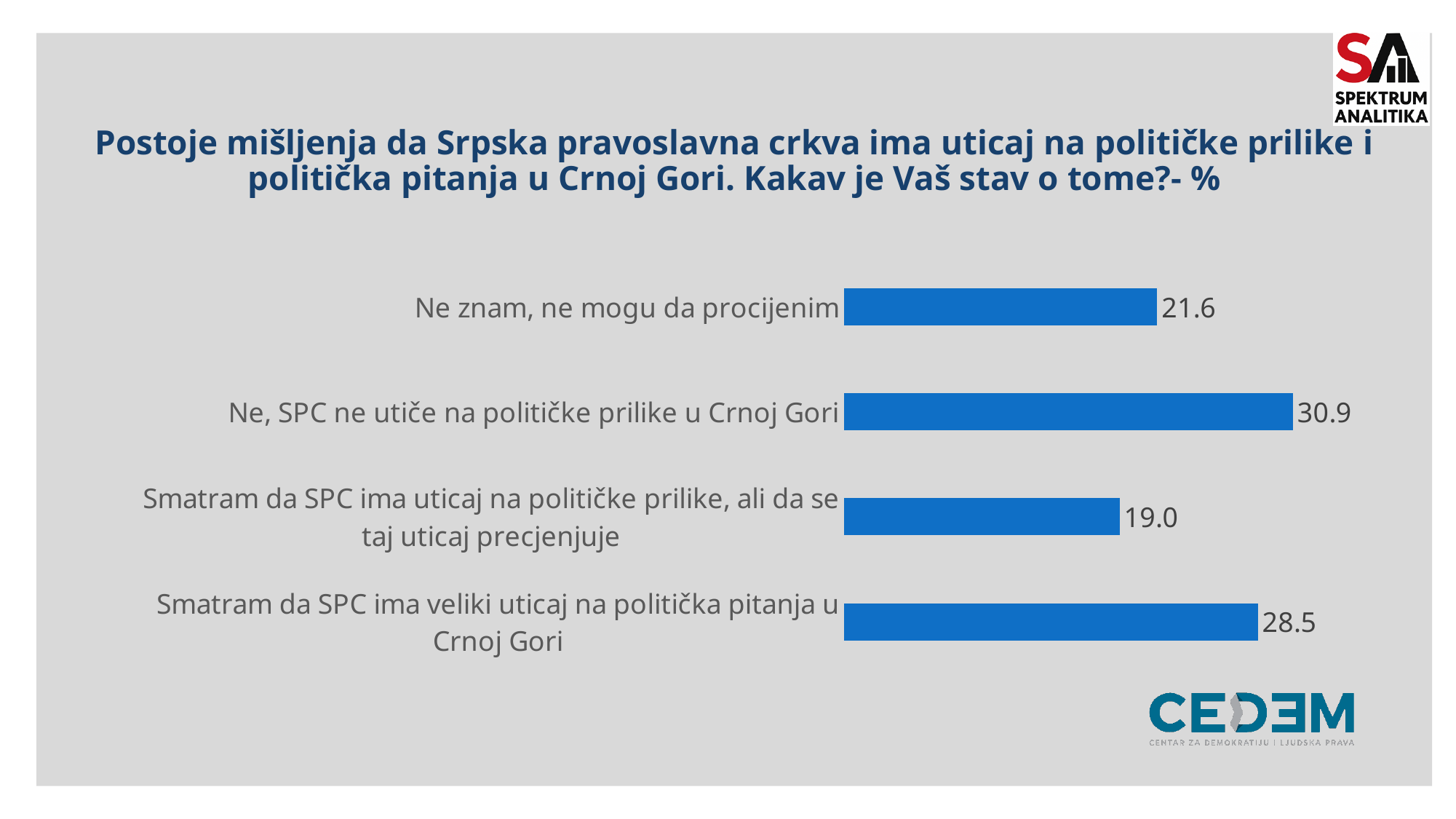
Which category has the highest value? Ne, SPC ne utiče na političke prilike u Crnoj Gori Which category has the lowest value? Smatram da SPC ima uticaj na političke prilike, ali da se taj uticaj precjenjuje What kind of chart is shown on the slide? Bar chart What is the difference between the values for "Ne, SPC ne utiče na političke prilike u Crnoj Gori" and "Smatram da SPC ima veliki uticaj na politička pitanja u Crnoj Gori"? 2.4 Which is larger: the value for "Ne znam, ne mogu da procijenim" or the value for "Smatram da SPC ima veliki uticaj na politička pitanja u Crnoj Gori"? Smatram da SPC ima veliki uticaj na politička pitanja u Crnoj Gori What is the value for "Smatram da SPC ima veliki uticaj na politička pitanja u Crnoj Gori"? 28.5 What is the difference between the values for "Ne znam, ne mogu da procijenim" and "Smatram da SPC ima uticaj na političke prilike, ali da se taj uticaj precjenjuje"? 2.6 What is the value for "Ne znam, ne mogu da procijenim"? 21.6 What colour are the bars in the chart? Blue How many categories are shown in the chart? 4 What is the value for "Ne, SPC ne utiče na političke prilike u Crnoj Gori"? 30.9 What is the value for "Smatram da SPC ima uticaj na političke prilike, ali da se taj uticaj precjenjuje"? 19.0